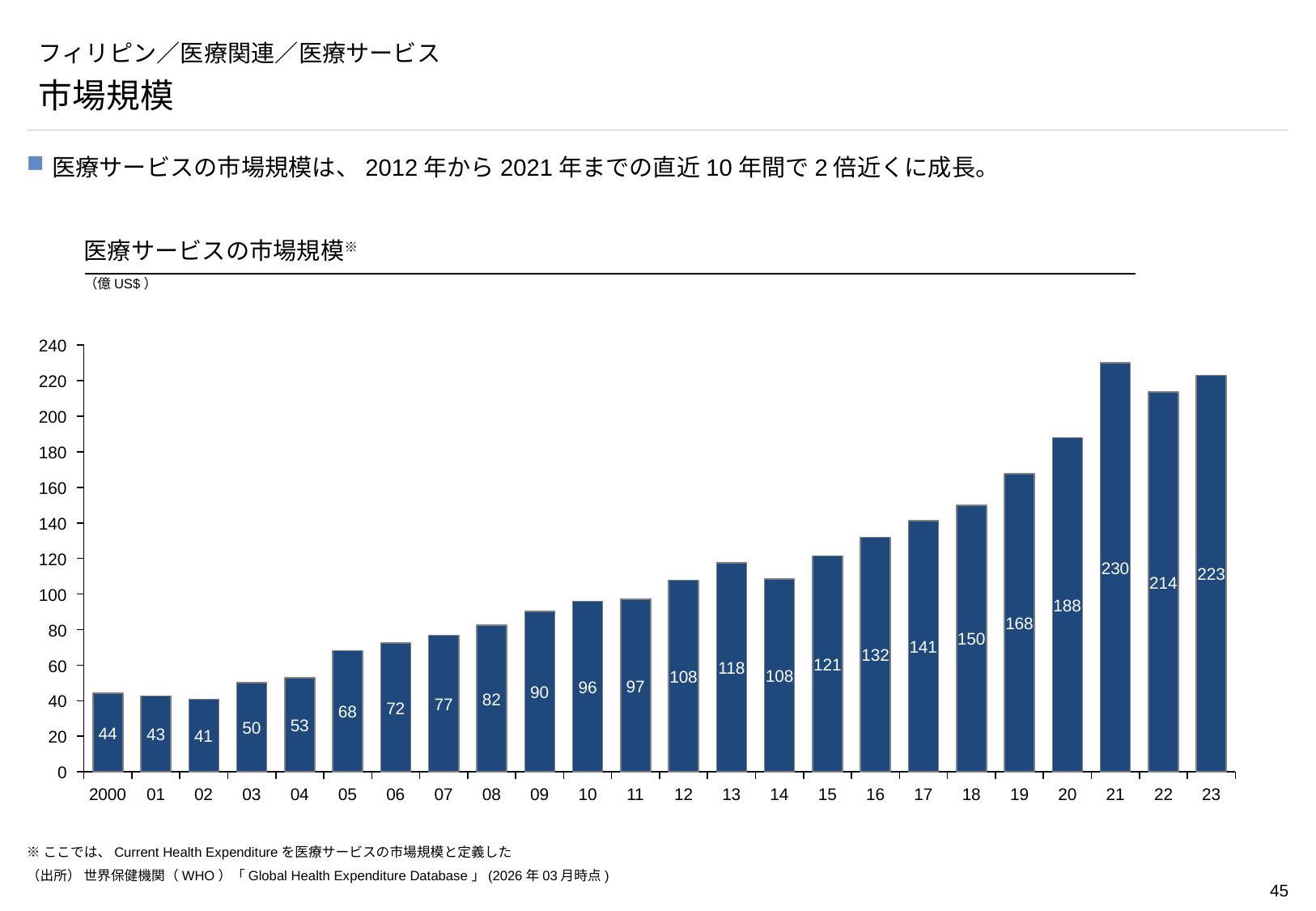
Which is larger, the value for 2021 or the value for 2023? 2021 What is the value for 2021 in the chart? 230 What is the value for 2000 in the chart? 44 Which year has the lowest value in the chart? 02 What kind of chart is shown on the slide? bar chart What is the value for 2014 in the chart? 108 What unit is shown for the chart values? 億US$ Is the value for 2019 greater or less than 160? greater What is the difference between the values for 2023 and 2022? 9 Which year has the highest value in the chart? 21 Do the values generally rise or fall from 2000 to 2023? rise How many years (bars) are shown in the chart? 24